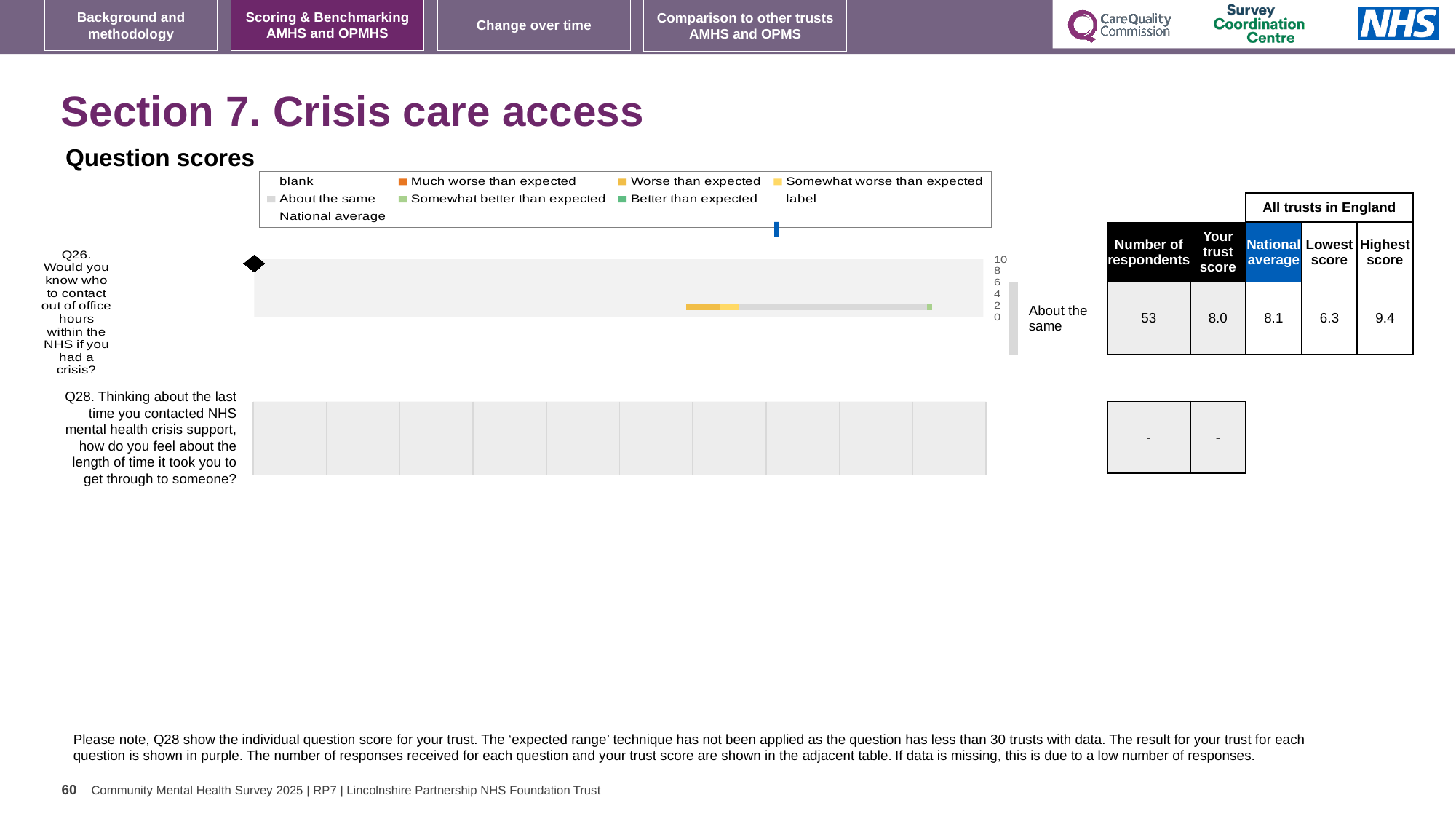
What is the trust score for Q26 (Would you know who to contact out of office hours within the NHS if you had a crisis?)? 8.0 What is shown as the trust score for Q28 in the table? - What colour represents 'Much worse than expected' in the legend? Orange What kind of chart is used to show the question scores? Bar chart For Q26, is the trust score higher or lower than the national average? Lower Which benchmarking category is Q26 placed in? About the same What is the national average score for Q26? 8.1 How many respondents answered Q26? 53 How many questions are shown in the chart? 2 What is the difference between the highest and lowest trust scores for Q26? 3.1 What is the lowest score among all trusts in England for Q26? 6.3 What is the highest score among all trusts in England for Q26? 9.4